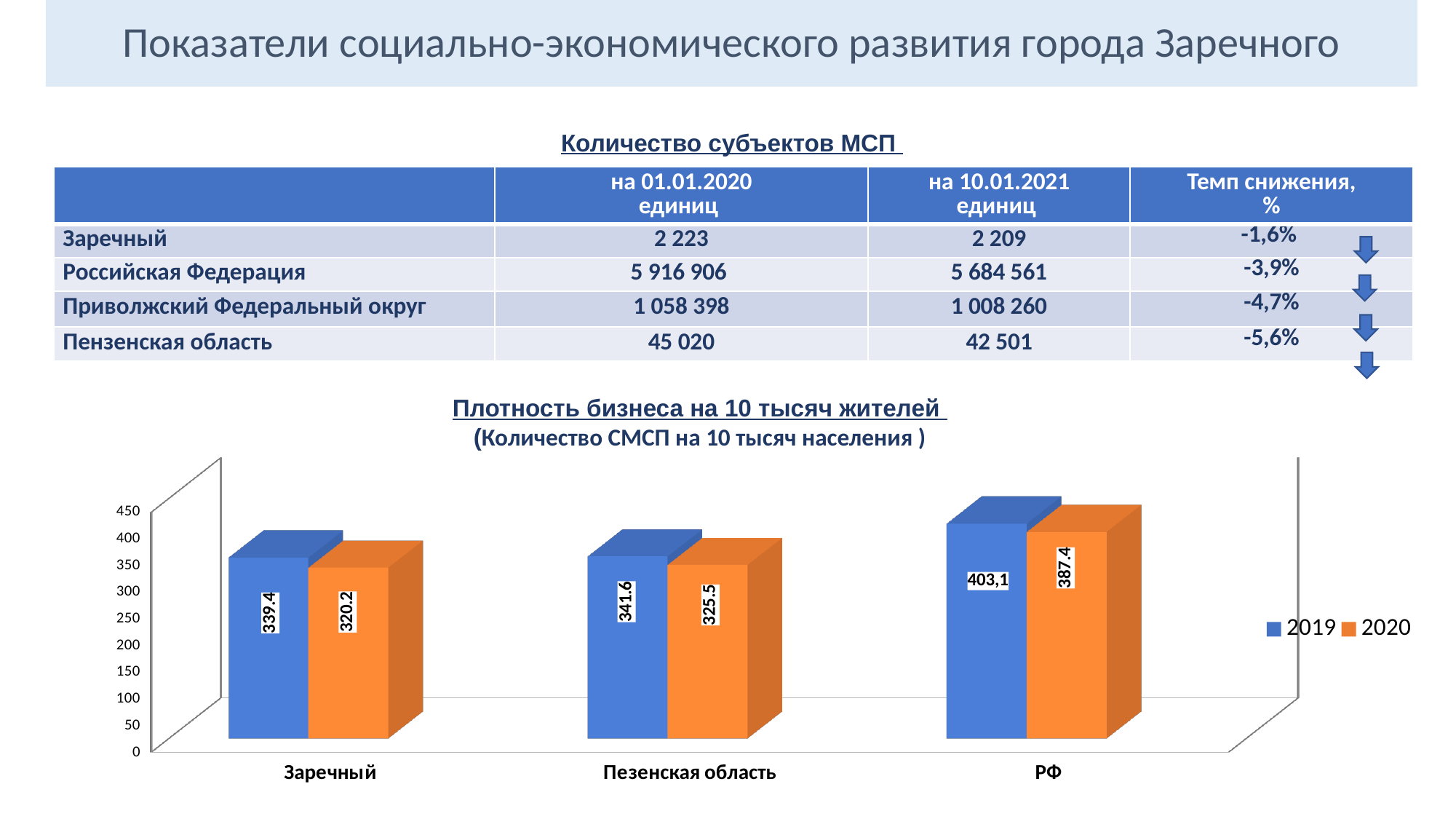
How many categories are shown on the x axis of the chart? 3 What is the 2020 value for Пезенская область in the chart? 325.5 What is the 2019 value for РФ in the chart? 403,1 What kind of chart is shown on the slide? bar chart Which category has the highest 2019 value in the chart? РФ Which category has the lowest 2020 value in the chart? Заречный Is the 2020 value for Заречный in the chart greater or less than 350? less What is the 2019 value for Заречный in the chart "Плотность бизнеса на 10 тысяч жителей"? 339.4 What is the difference between the 2019 and 2020 values for Заречный in the chart? 19.2 How many series does the chart's legend list? 2 What is the 2020 value for РФ in the chart? 387.4 Which is larger in the chart: the 2019 value for Заречный or the 2019 value for Пезенская область? Пезенская область